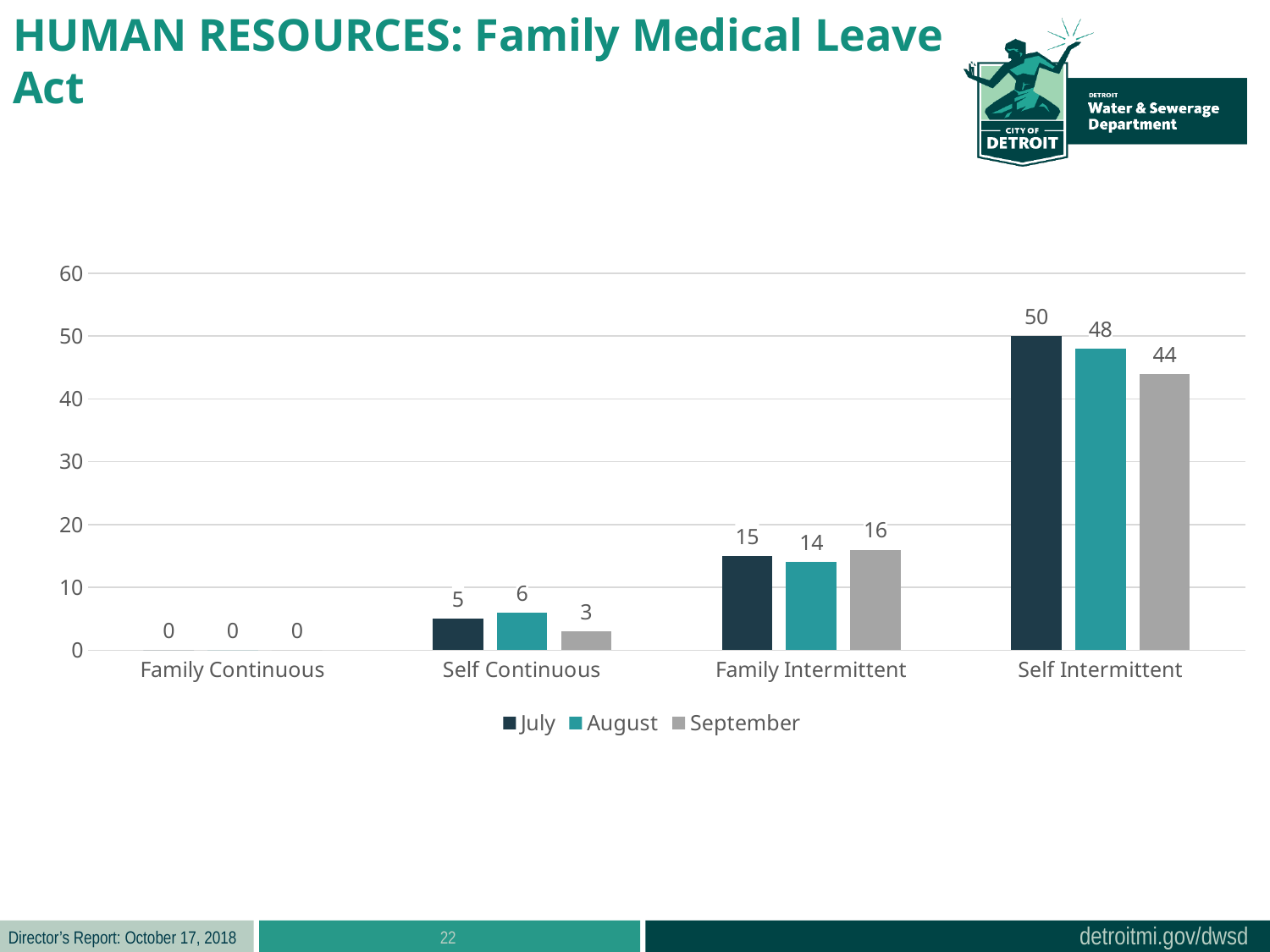
What is the value for July in the Self Intermittent category? 50 How many series does the legend list? 3 What is the value for September in the Self Continuous category? 3 Which category has the lowest value for September? Family Continuous What kind of chart is shown on the slide? bar chart Is the value for August in the Self Intermittent category greater or less than 40? greater Which is larger in the Self Continuous category, the July value or the August value? August Which series is shown in grey in the legend? September What is the difference between the July and September values for Self Intermittent? 6 What is the value for August in the Family Intermittent category? 14 How many categories are shown on the x axis? 4 Which category has the highest value for July? Self Intermittent